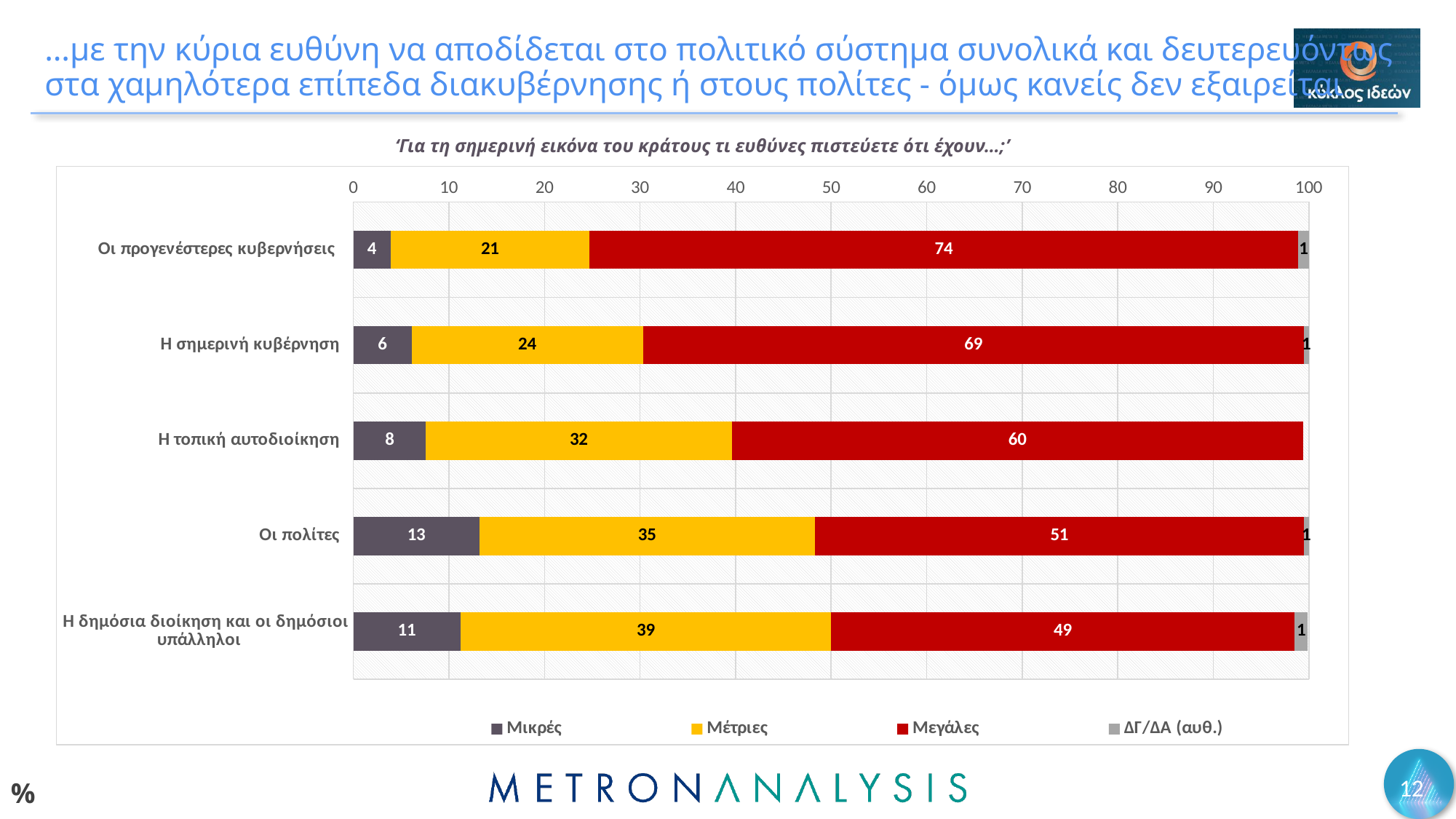
What is the value of 'Μικρές' for 'Οι πολίτες'? 13 What is the value of 'Μέτριες' for 'Η δημόσια διοίκηση και οι δημόσιοι υπάλληλοι'? 39 How many series does the legend list? 4 How many categories are shown on the chart? 5 Which category has the lowest value for 'Μικρές'? Οι προγενέστερες κυβερνήσεις What is the value of 'Μεγάλες' for 'Οι προγενέστερες κυβερνήσεις'? 74 Which category has the highest value for 'Μεγάλες'? Οι προγενέστερες κυβερνήσεις What kind of chart is shown on the slide? Stacked bar chart What is the difference between the 'Μεγάλες' values for 'Η σημερινή κυβέρνηση' and 'Η τοπική αυτοδιοίκηση'? 9 Which is larger: the 'Μέτριες' value for 'Οι πολίτες' or for 'Η τοπική αυτοδιοίκηση'? Οι πολίτες Which colour represents the 'Μεγάλες' series in the legend? Red What is the total of the stacked bar for 'Η τοπική αυτοδιοίκηση'? 100